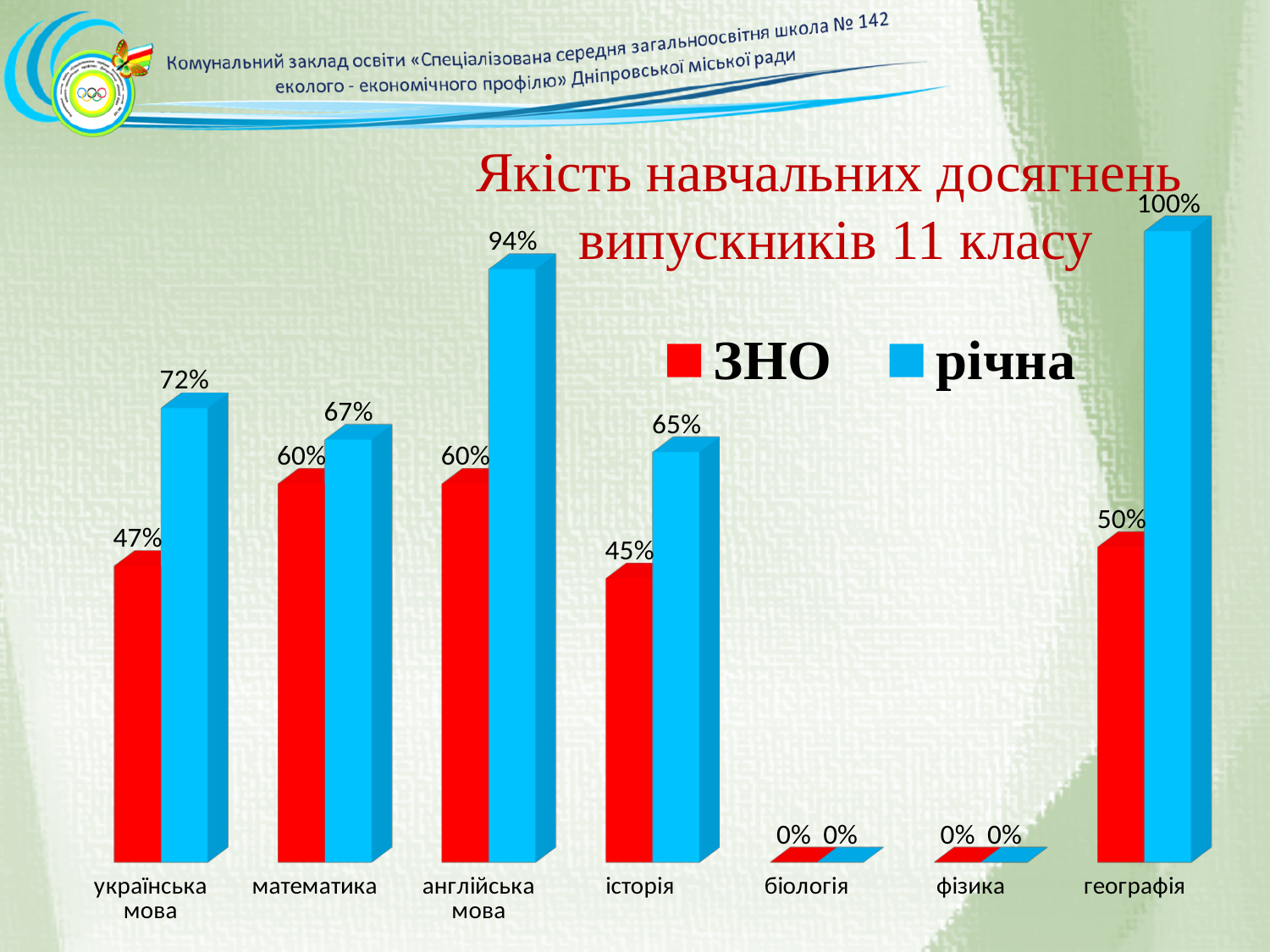
Which is larger for математика: the ЗНО value or the річна value? річна Which category has the highest річна value? географія What is the ЗНО value for українська мова? 47% Which colour represents the ЗНО series? red Among the categories with non-zero values, which has the lowest ЗНО value? історія What kind of chart is shown on the slide? bar chart What is the річна value for географія? 100% What is the ЗНО value for історія? 45% What is the річна value for англійська мова? 94% How many categories are shown on the x axis? 7 How many series does the legend list? 2 What is the difference between the річна and ЗНО values for англійська мова? 34%